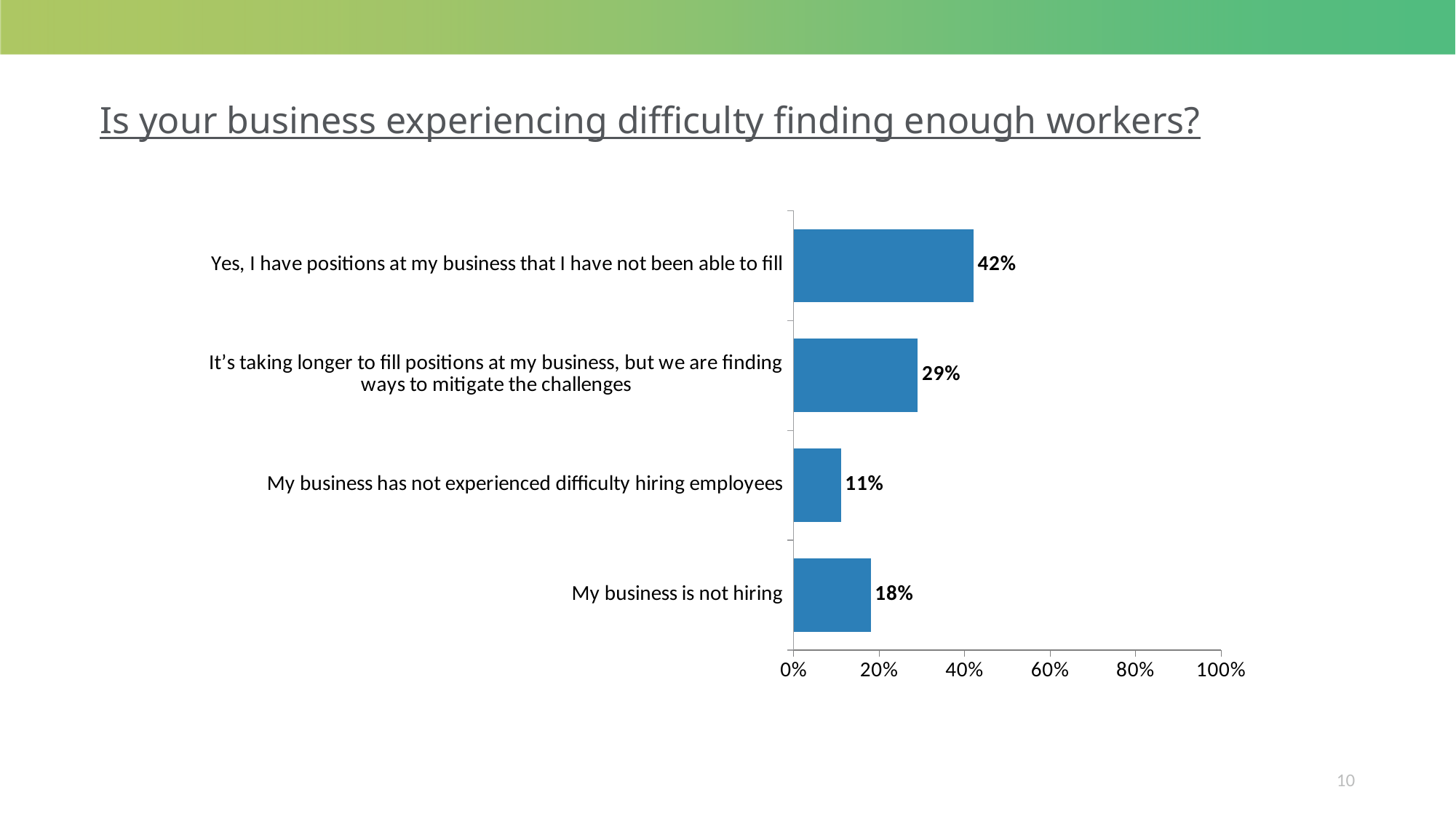
What percentage of respondents said their business is not hiring? 18% Which is larger: the percentage for 'My business is not hiring' or for 'My business has not experienced difficulty hiring employees'? My business is not hiring Is the value for 'It's taking longer to fill positions at my business, but we are finding ways to mitigate the challenges' greater or less than 40%? less What is the difference in percentage points between the 'Yes, I have positions at my business that I have not been able to fill' response and the 'My business is not hiring' response? 24 percentage points What percentage of respondents said they have positions at their business that they have not been able to fill? 42% What percentage of respondents said their business has not experienced difficulty hiring employees? 11% Which response has the lowest percentage? My business has not experienced difficulty hiring employees What is the title of the slide? Is your business experiencing difficulty finding enough workers? How many response categories are shown in the chart? 4 What percentage of respondents said it's taking longer to fill positions but they are finding ways to mitigate the challenges? 29% Which response has the highest percentage? Yes, I have positions at my business that I have not been able to fill What type of chart is shown on the slide? Bar chart